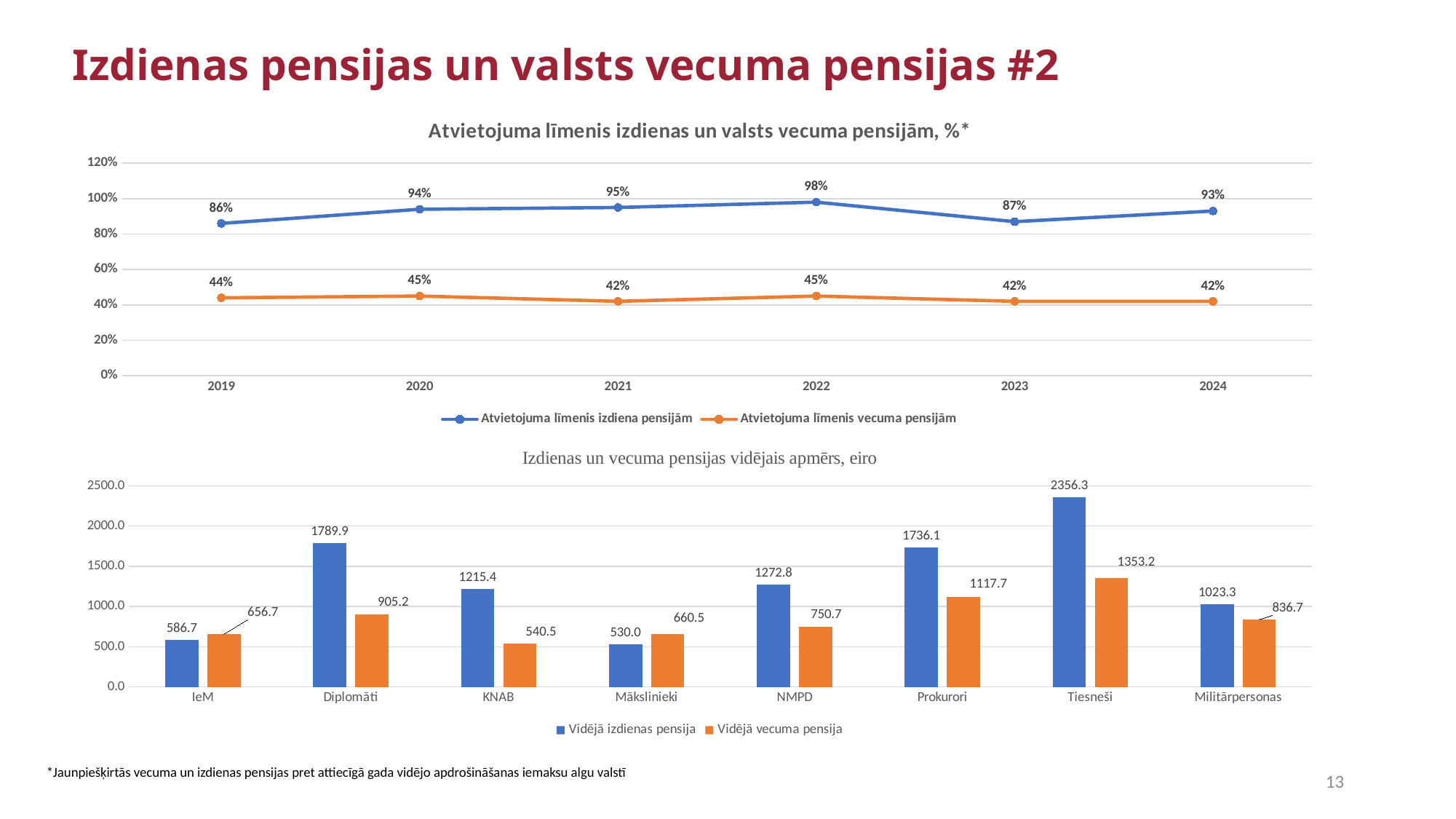
In the bottom chart 'Izdienas un vecuma pensijas vidējais apmērs, eiro', what is the value of 'Vidējā vecuma pensija' for KNAB? 540.5 In the bottom chart 'Izdienas un vecuma pensijas vidējais apmērs, eiro', what is the difference between 'Vidējā izdienas pensija' and 'Vidējā vecuma pensija' for Diplomāti? 884.7 In the top chart 'Atvietojuma līmenis izdienas un valsts vecuma pensijām, %*', what is the value for 'Atvietojuma līmenis izdiena pensijām' in 2022? 98% In the top chart 'Atvietojuma līmenis izdienas un valsts vecuma pensijām, %*', in which year is 'Atvietojuma līmenis izdiena pensijām' lowest? 2019 In the top chart 'Atvietojuma līmenis izdienas un valsts vecuma pensijām, %*', what is the difference between the two series in 2023? 45% In the bottom chart 'Izdienas un vecuma pensijas vidējais apmērs, eiro', which is larger for IeM: 'Vidējā izdienas pensija' or 'Vidējā vecuma pensija'? Vidējā vecuma pensija How many series does the legend of the bottom chart 'Izdienas un vecuma pensijas vidējais apmērs, eiro' list? 2 In the bottom chart 'Izdienas un vecuma pensijas vidējais apmērs, eiro', which category has the lowest 'Vidējā izdienas pensija'? Mākslinieki In the top chart 'Atvietojuma līmenis izdienas un valsts vecuma pensijām, %*', what is the value for 'Atvietojuma līmenis vecuma pensijām' in 2019? 44% What kind of chart is the top chart 'Atvietojuma līmenis izdienas un valsts vecuma pensijām, %*'? Line chart In the bottom chart 'Izdienas un vecuma pensijas vidējais apmērs, eiro', what is the value of 'Vidējā izdienas pensija' for Tiesneši? 2356.3 In the top chart 'Atvietojuma līmenis izdienas un valsts vecuma pensijām, %*', how many years are shown on the x axis? 6